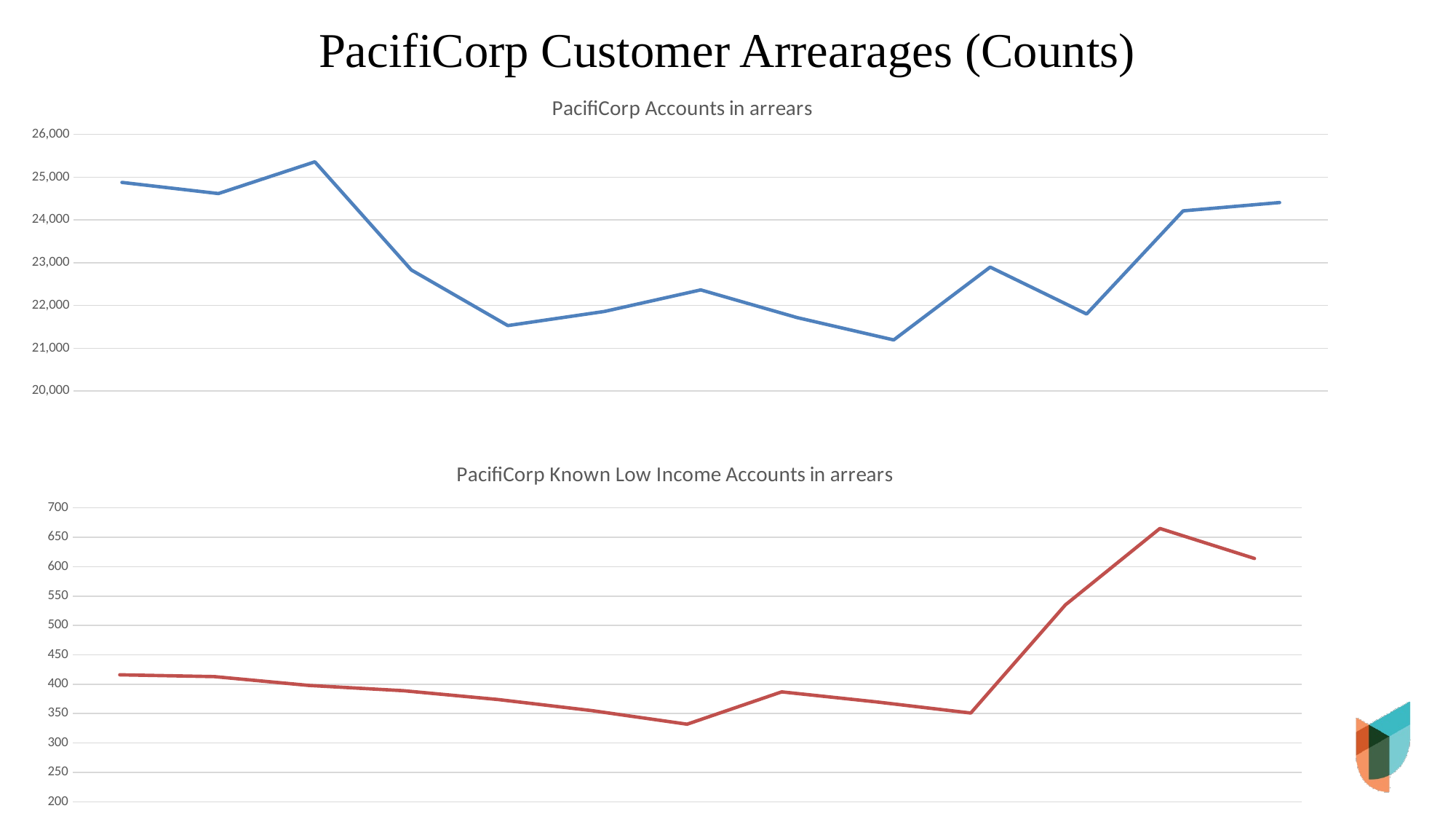
On the "PacifiCorp Accounts in arrears" chart, is the highest point on the line greater or less than 25,000? greater What is the title of the lower chart on the slide? PacifiCorp Known Low Income Accounts in arrears On the "PacifiCorp Known Low Income Accounts in arrears" chart, is the lowest point on the line greater or less than 350? less On the "PacifiCorp Known Low Income Accounts in arrears" chart, is the highest point on the line greater or less than 600? greater What kind of chart is the "PacifiCorp Known Low Income Accounts in arrears" chart at the bottom of the slide? line chart On the "PacifiCorp Accounts in arrears" chart, is the first point of the line higher or lower than the last point? higher What kind of chart is the "PacifiCorp Accounts in arrears" chart at the top of the slide? line chart How many data points are plotted on the "PacifiCorp Accounts in arrears" chart? 13 How many charts are shown on the slide? 2 On the "PacifiCorp Known Low Income Accounts in arrears" chart, does the line end higher or lower than it starts? higher